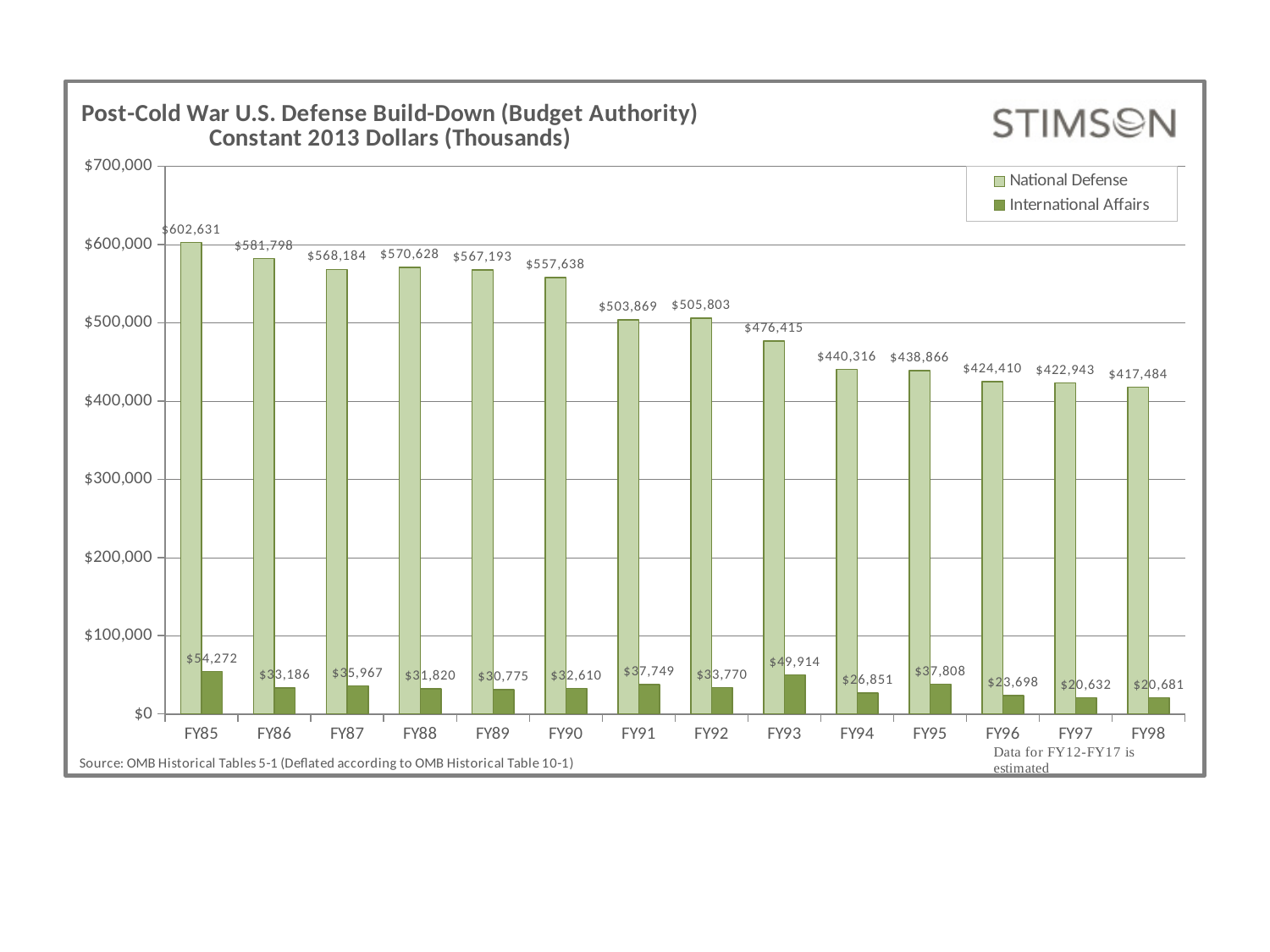
Which is larger, the National Defense value for FY87 or for FY88? FY88 What is the National Defense value for FY98? $417,484 How many fiscal years are shown on the x axis? 14 Is the National Defense value for FY91 greater or less than $500,000? greater Which fiscal year has the highest National Defense value? FY85 How many series does the legend list? 2 Which fiscal year has the lowest National Defense value? FY98 Do the National Defense values generally rise or fall from FY85 to FY98? fall Which fiscal year has the highest International Affairs value? FY85 What is the difference between the National Defense values for FY85 and FY98? $185,147 What is the National Defense value for FY85? $602,631 What is the International Affairs value for FY93? $49,914